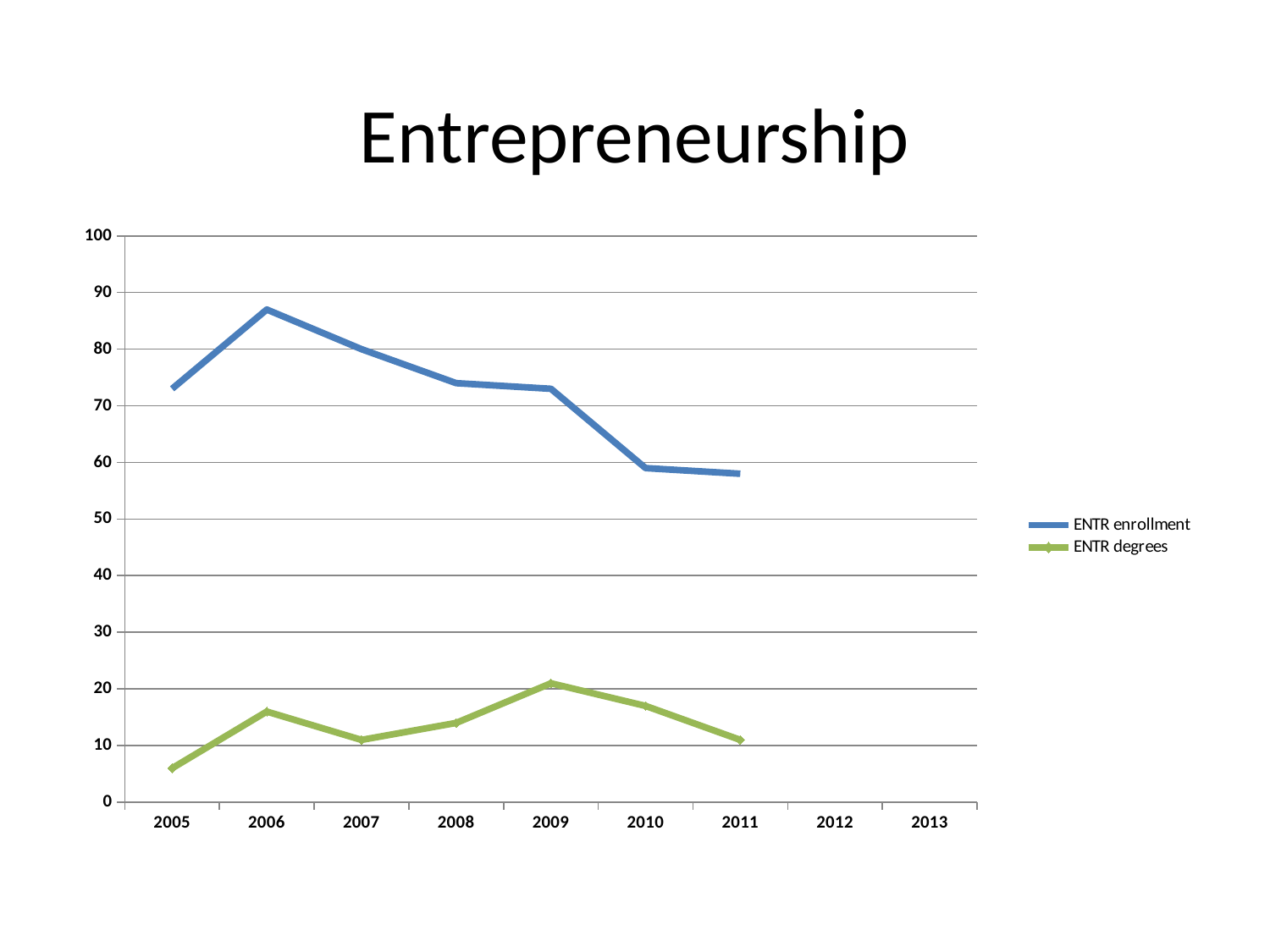
Does ENTR enrollment rise or fall from 2006 to 2011? fall What kind of chart is shown on the slide? line chart In which year is ENTR degrees lowest? 2005 Which series is drawn in green? ENTR degrees Which is larger, ENTR degrees in 2006 or ENTR degrees in 2007? 2006 In which year is ENTR degrees highest? 2009 What is the title of the chart? Entrepreneurship Is the value for ENTR enrollment in 2006 greater or less than 80? greater How many series does the legend list? 2 In which year is ENTR enrollment highest? 2006 Is the value for ENTR degrees in 2005 greater or less than 10? less